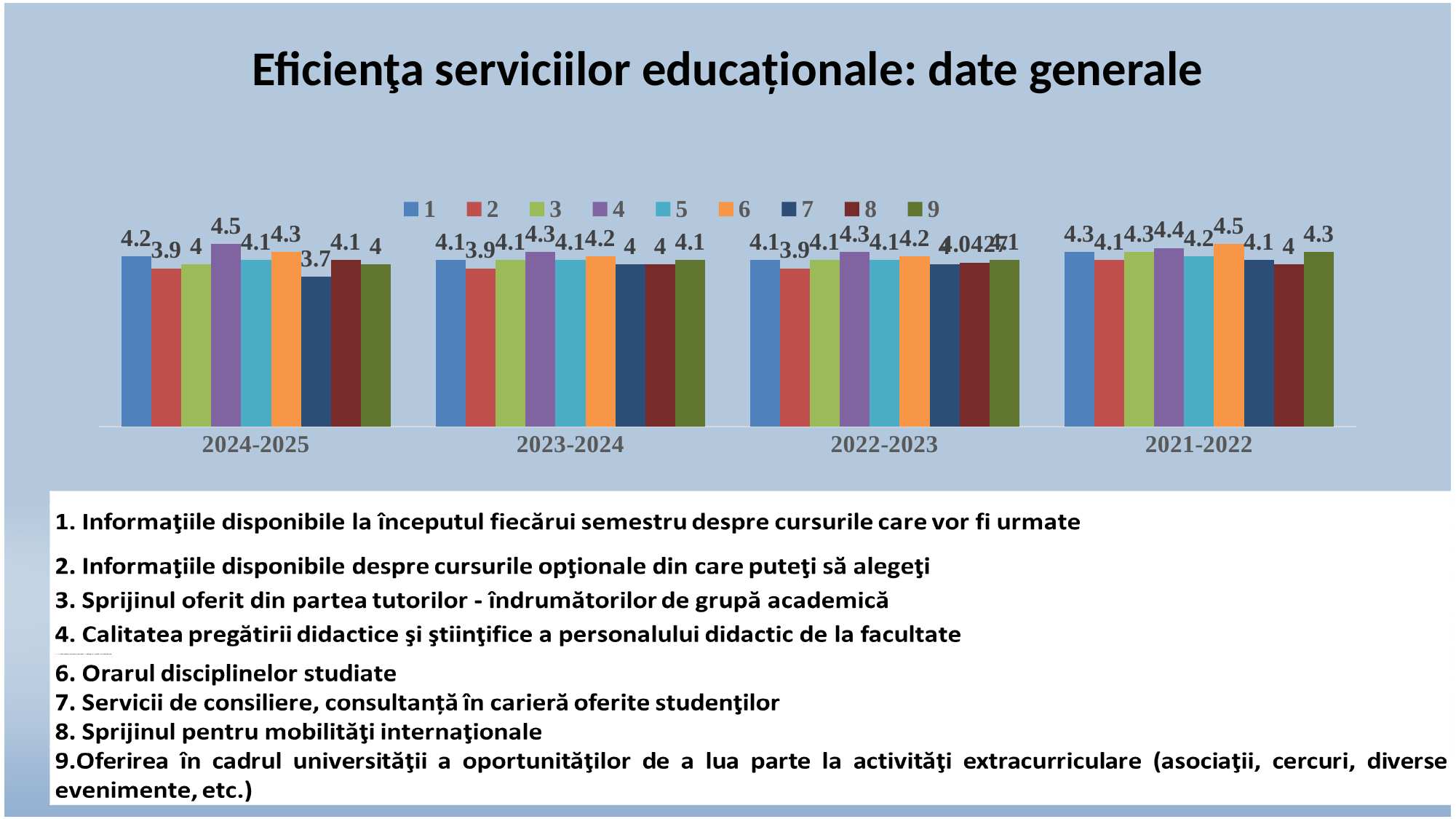
What is the value for series 4 in 2024-2025? 4.5 Which is larger in 2021-2022: series 6 or series 8? series 6 What is the difference between series 4 and series 7 in 2024-2025? 0.8 How many year groups are shown on the x axis? 4 What kind of chart is shown on the slide? bar chart How many series does the legend list? 9 What is the value for series 2 in 2023-2024? 3.9 What is the title of the slide containing the chart? Eficienţa serviciilor educaționale: date generale Which series has the lowest value in the 2024-2025 group? 7 What is the value for series 6 in 2021-2022? 4.5 What is the value for series 7 in 2024-2025? 3.7 Which series has the highest value in the 2024-2025 group? 4